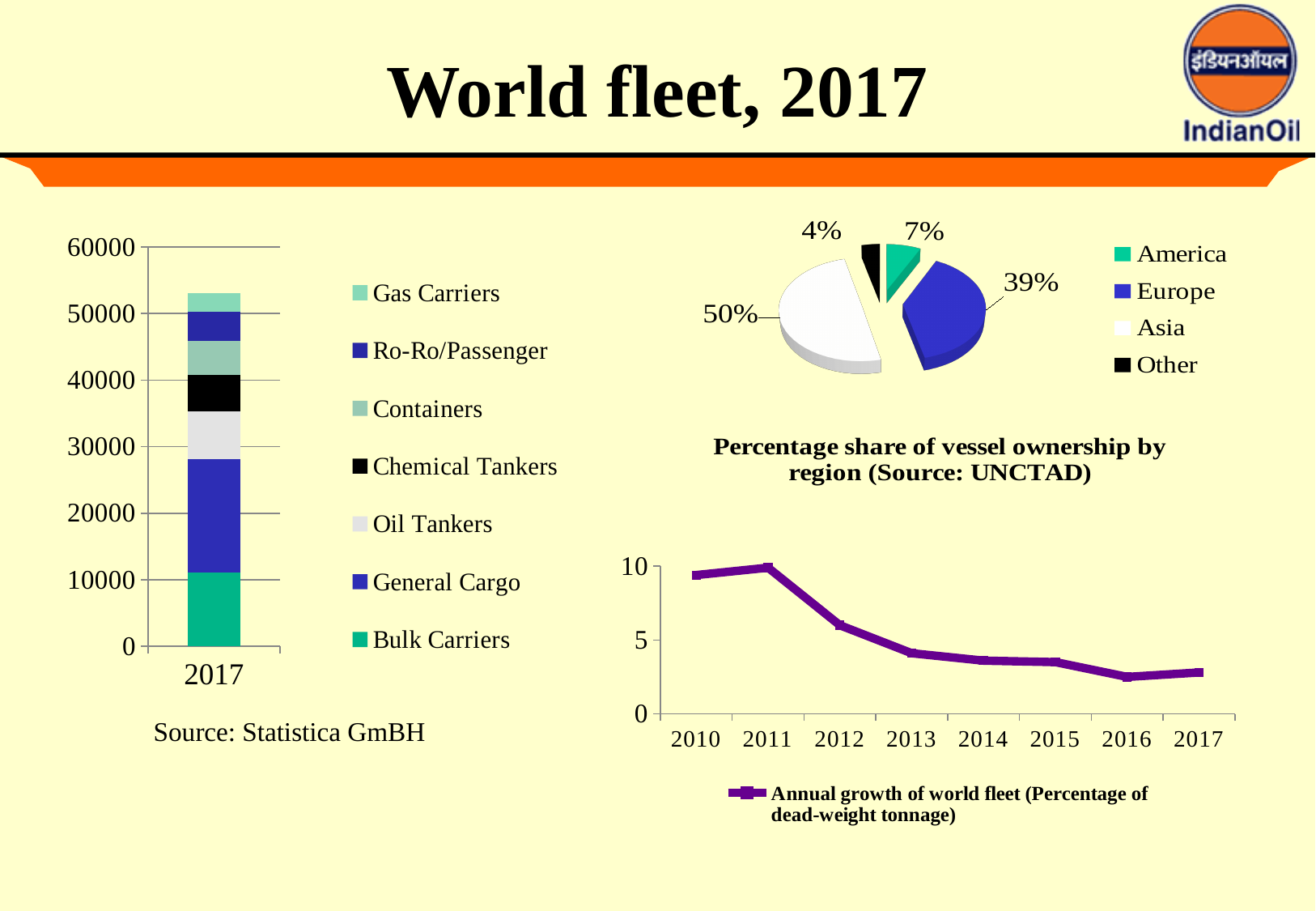
In the line chart 'Annual growth of world fleet', how many years are plotted on the x axis? 8 In the pie chart 'Percentage share of vessel ownership by region', what is the share for Europe? 39% In the pie chart 'Percentage share of vessel ownership by region', what is the share for Asia? 50% In the pie chart 'Percentage share of vessel ownership by region', which region has the smallest share? Other In the pie chart 'Percentage share of vessel ownership by region', which region has the largest share? Asia In the stacked bar chart on the left of the slide, how many vessel types does the legend list? 7 In the pie chart 'Percentage share of vessel ownership by region', how many regions are shown in the legend? 4 In the pie chart 'Percentage share of vessel ownership by region', what is the difference in percentage points between Europe and America? 32 What kind of chart is the chart on the left of the slide with the 2017 category? Stacked bar chart In the line chart 'Annual growth of world fleet', do the values generally rise or fall from 2010 to 2017? fall In the stacked bar chart on the left of the slide, is the total height of the 2017 bar greater or less than 50000? greater In the line chart 'Annual growth of world fleet', is the value for 2016 greater or less than 5? less